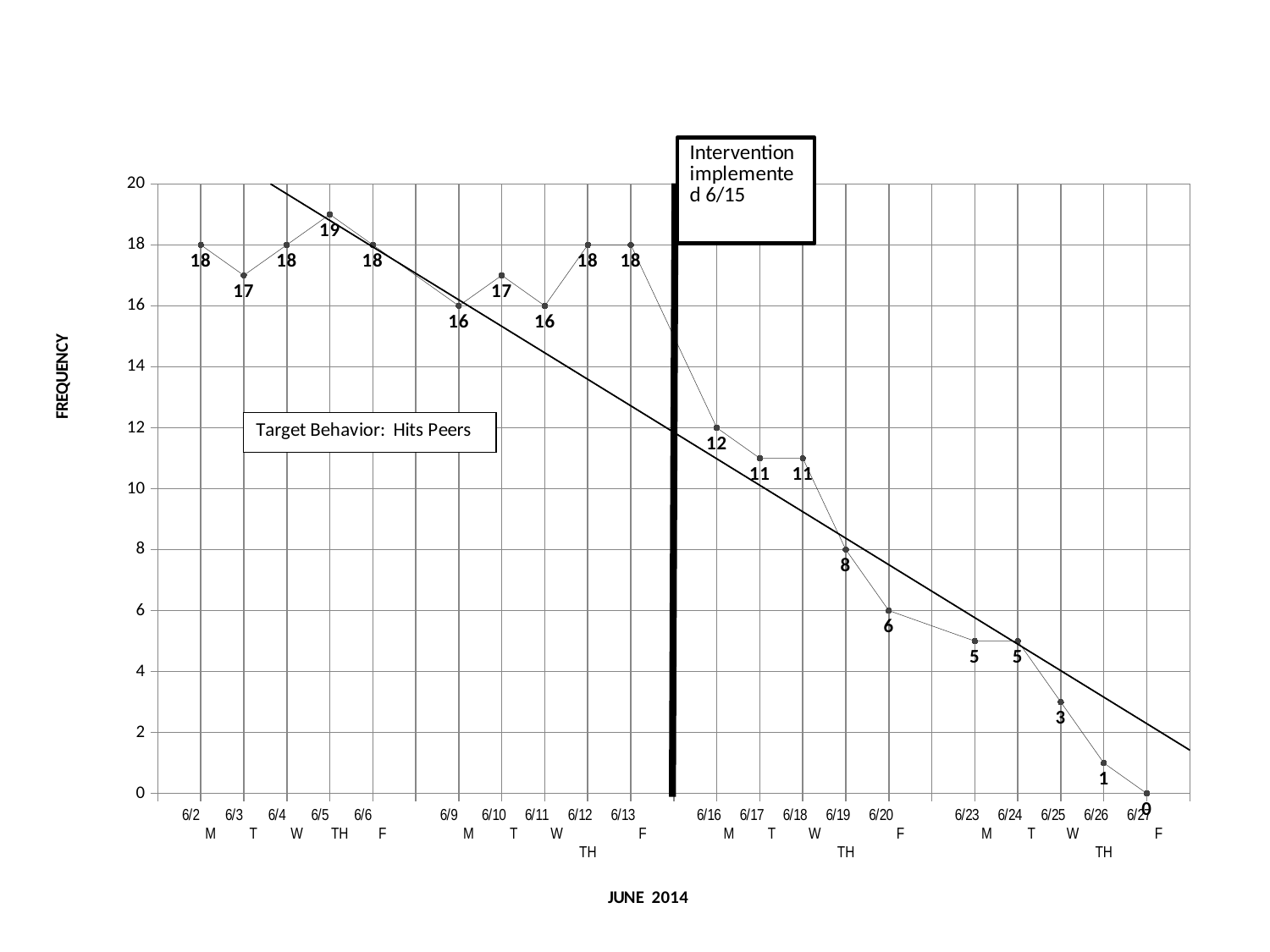
What is the frequency value for 6/19? 8 Do the frequency values generally rise or fall from 6/16 to 6/27? Fall What is the y-axis label of the chart? FREQUENCY Which date has the lowest frequency? 6/27 What is the frequency value for 6/5? 19 How many data points are plotted on the chart? 20 Which date has the highest frequency? 6/5 What is the frequency value for 6/16? 12 What kind of chart is shown on the slide? Line chart What is the frequency value for 6/27? 0 What is the difference between the frequency on 6/13 and the frequency on 6/16? 6 Which has a higher frequency, 6/20 or 6/25? 6/20